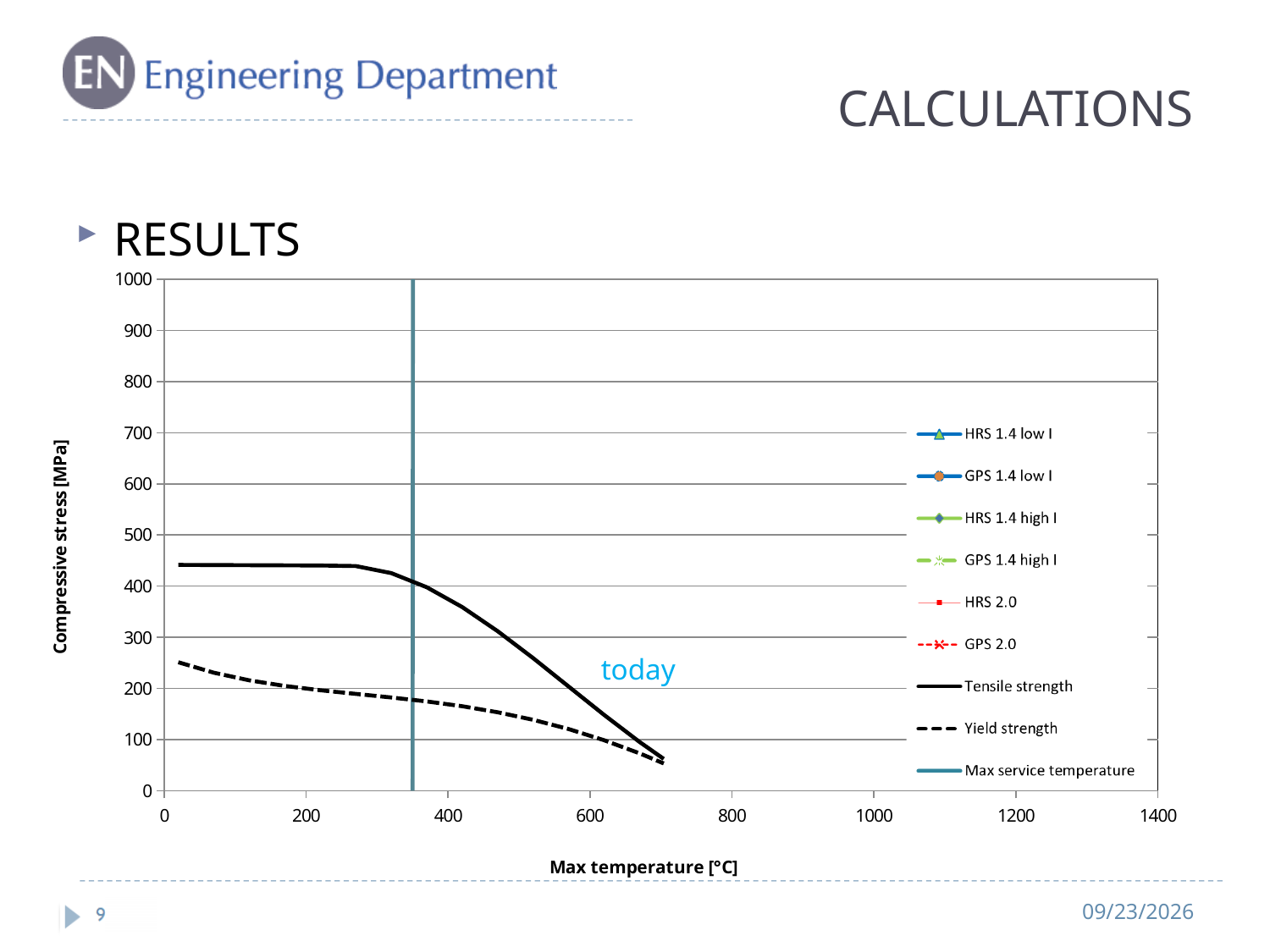
Is the Max service temperature vertical line located at a temperature greater or less than 400 °C? less What is the label of the x axis of the chart? Max temperature [°C] What kind of chart is shown on the slide? line chart At 400 °C, which is larger: Tensile strength or Yield strength? Tensile strength Does the Yield strength curve rise or fall as Max temperature increases along the x axis? fall Is the Yield strength value at 0 °C greater or less than 200 MPa? greater Is the Tensile strength value at 200 °C greater or less than 400 MPa? greater What is the label of the y axis of the chart? Compressive stress [MPa] How many series does the chart legend list? 9 Does the Tensile strength curve rise or fall as Max temperature increases from 400 to 700 °C? fall